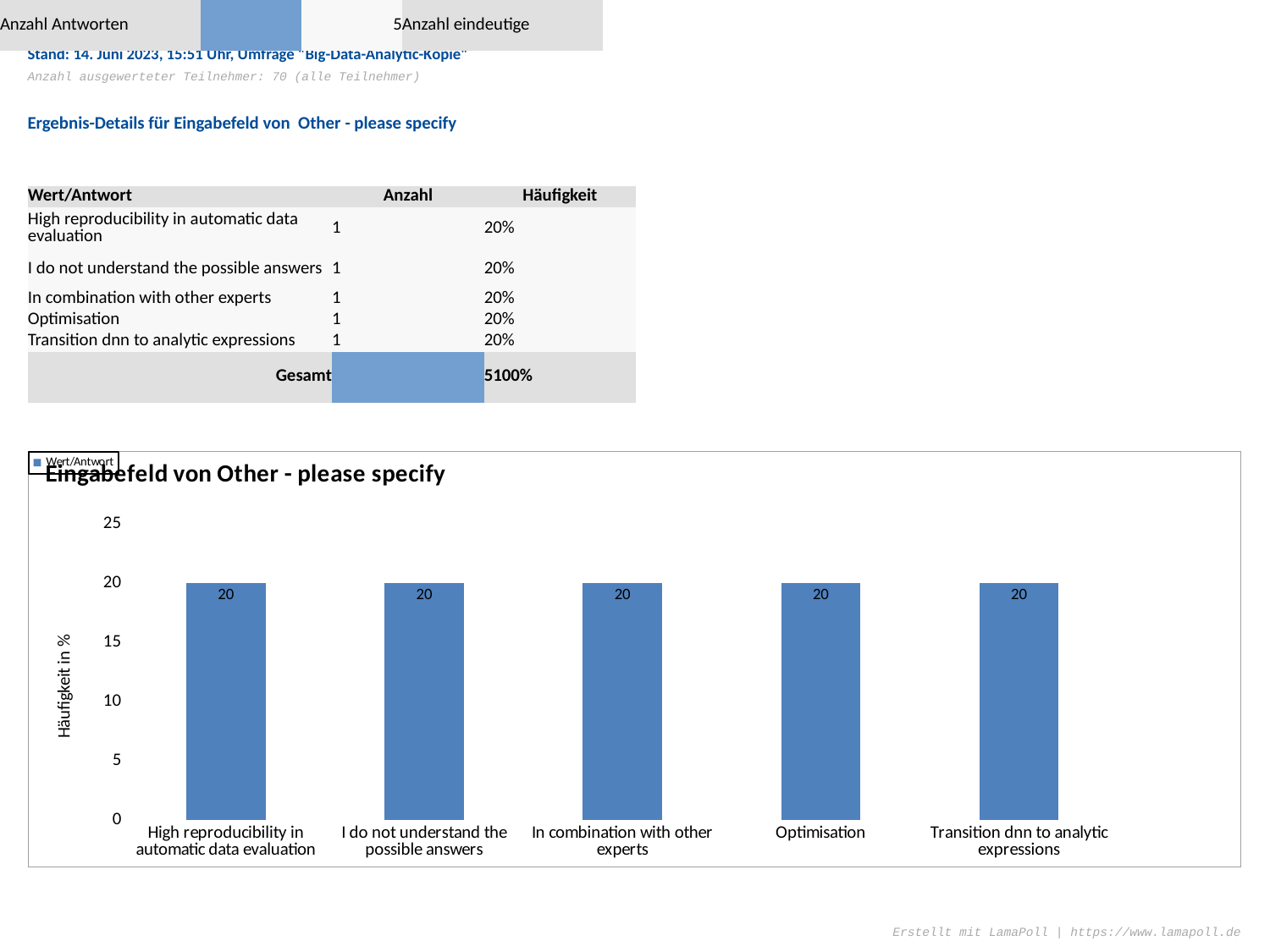
What value is shown for the bar labelled "In combination with other experts"? 20 What is the difference between the values for "Optimisation" and "In combination with other experts"? 0 What value is shown for the bar labelled "High reproducibility in automatic data evaluation"? 20 What value is shown for the bar labelled "Transition dnn to analytic expressions"? 20 Is the value for "I do not understand the possible answers" greater or less than 25? less How many bars (categories) does the chart show? 5 What value is shown for the bar labelled "Optimisation"? 20 What kind of chart is shown on the slide? bar chart What is the title of the chart? Eingabefeld von Other - please specify What is the label of the vertical axis of the chart? Häufigkeit in % Is the value for "Optimisation" greater or less than 15? greater How many series does the chart legend list? 1